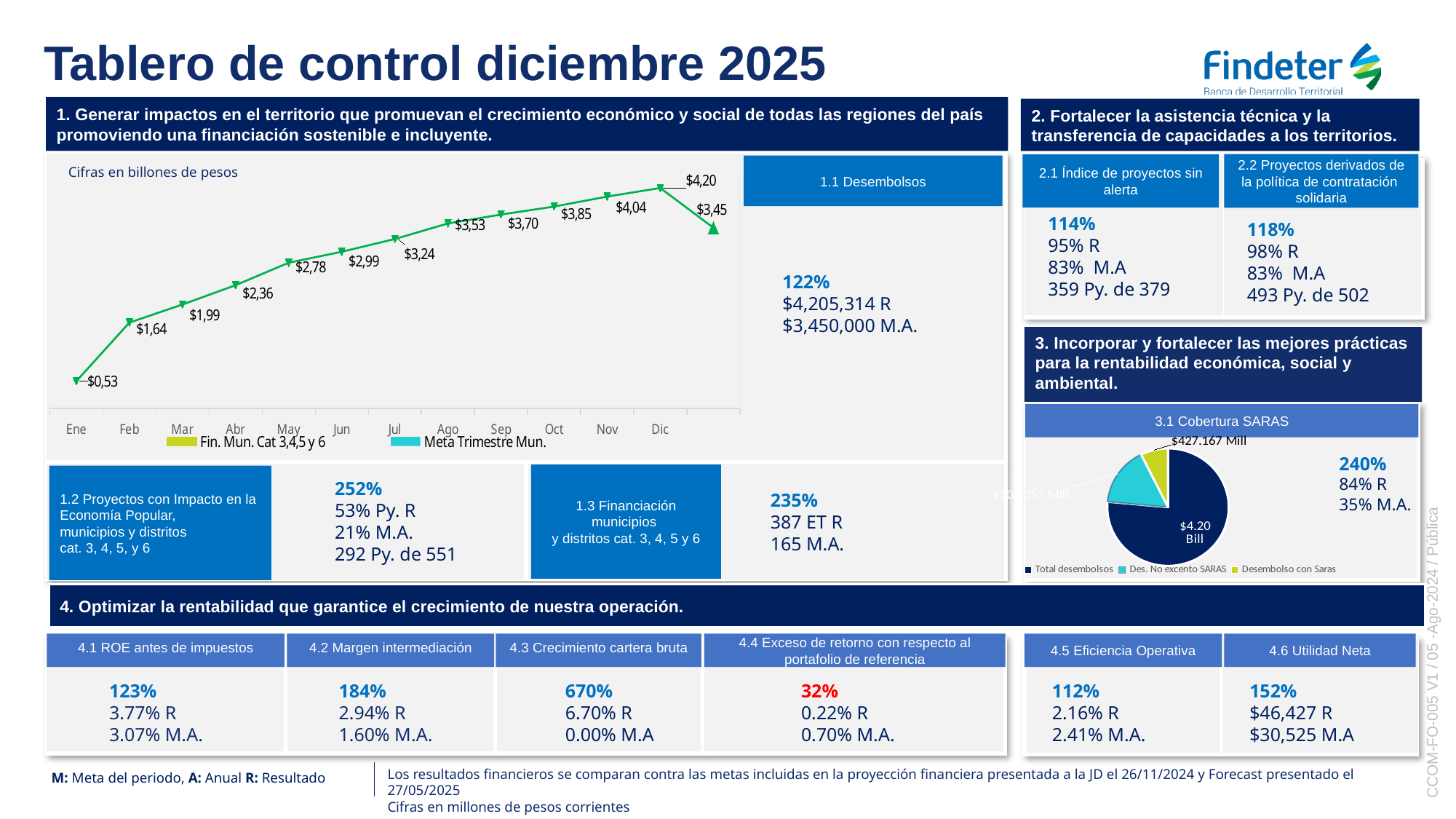
What kind of chart is the 3.1 Cobertura SARAS chart? pie chart In the 1.1 Desembolsos line chart, which month has the lowest value? Ene In the 1.1 Desembolsos line chart, which is larger, the value for Mar or the value for Abr? Abr In the 1.1 Desembolsos line chart, do the values rise or fall from Ene to Dic? rise How many month labels are shown on the x axis of the 1.1 Desembolsos line chart? 12 In the 1.1 Desembolsos line chart, what is the value labelled for Ene? $0,53 In the 1.1 Desembolsos line chart, what is the value labelled for Dic? $4,20 How many entries does the legend of the 3.1 Cobertura SARAS pie chart list? 3 In the 1.1 Desembolsos line chart, what is the value labelled for Jun? $2,99 In the 1.1 Desembolsos line chart, what is the difference between the Dic value and the Ene value? $3,67 In the 1.1 Desembolsos line chart, which month from Ene to Dic has the highest value? Dic What kind of chart is the 1.1 Desembolsos chart on the left of the slide? line chart